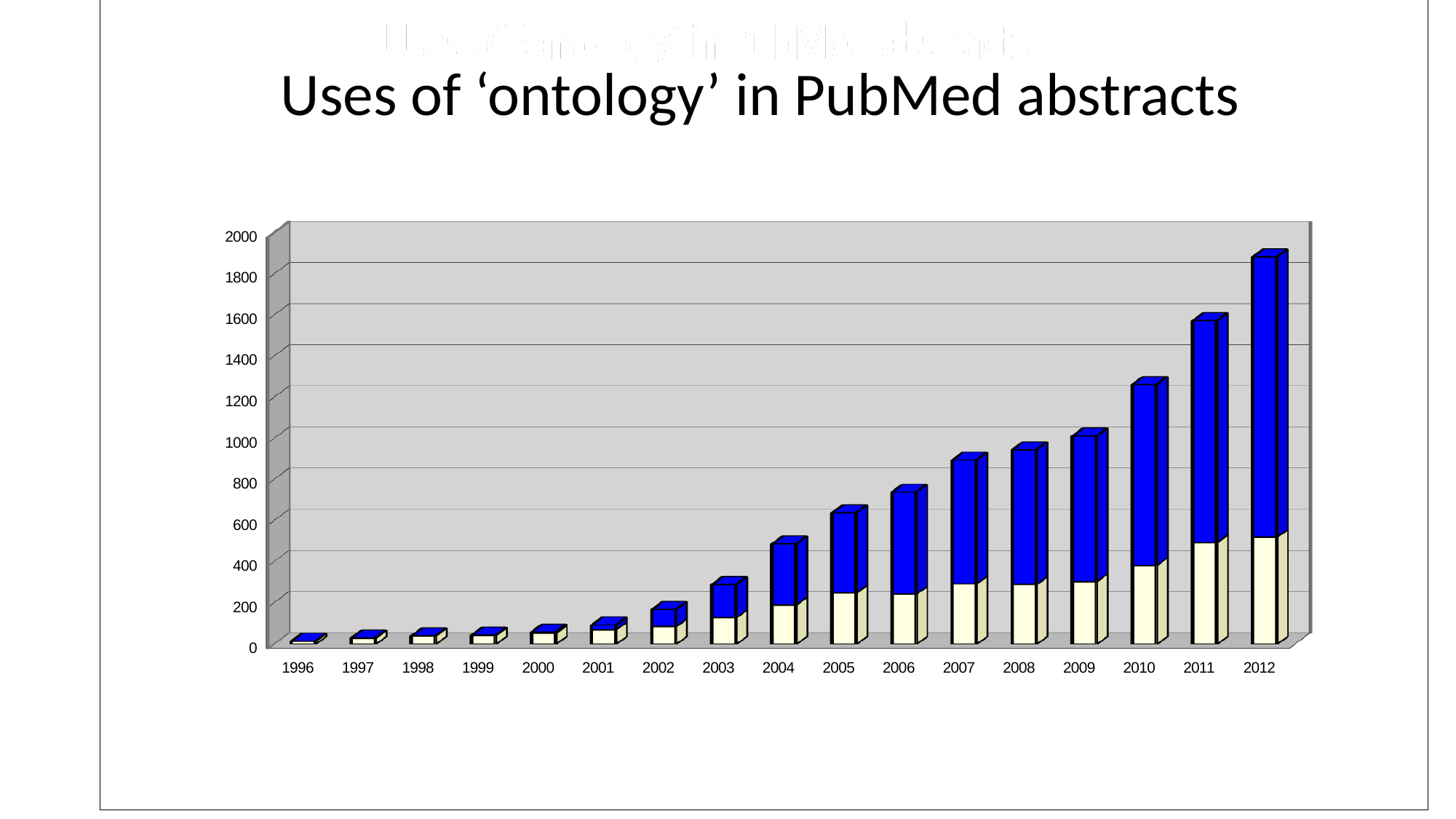
Is the total value for 2011 greater or less than 1400? greater Do the bar totals generally rise or fall from 1996 to 2012? Rise Is the total value for 2012 greater or less than 1600? greater Is the total value for 2009 greater or less than 1200? less How many years are shown along the x axis of the chart? 17 What kind of chart is shown on the slide? Bar chart What is the title of the chart on the slide? Uses of 'ontology' in PubMed abstracts Which year has the highest total bar? 2012 Which year has the larger total bar, 2011 or 2008? 2011 Which year has the lowest total bar? 1996